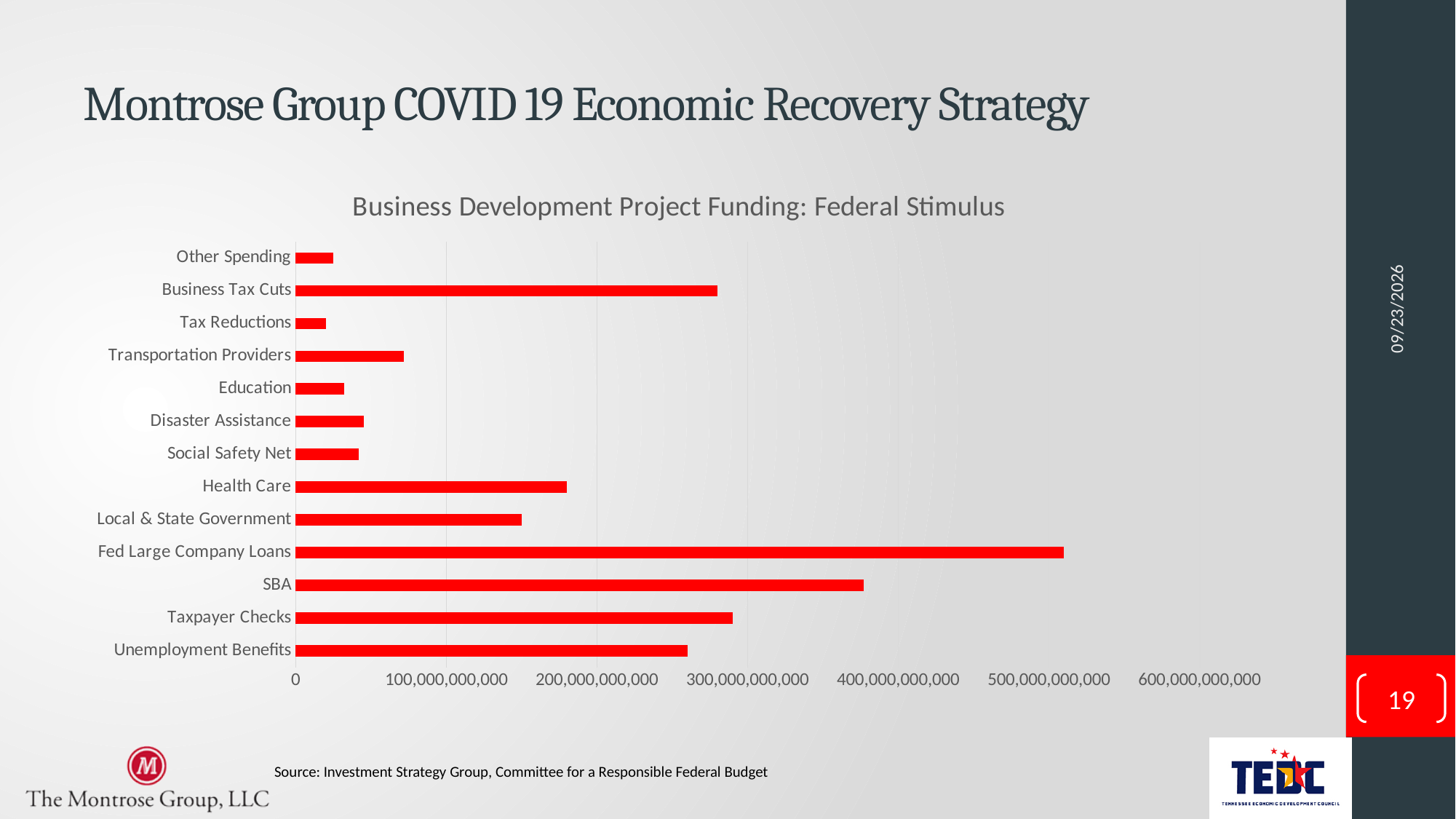
Is the value for SBA greater or less than 300,000,000,000? greater Which is larger, the value for Health Care or the value for Local & State Government? Health Care How many categories are plotted in the chart? 13 Which category has the highest value in the chart? Fed Large Company Loans Is the value for Transportation Providers greater or less than 100,000,000,000? less Is the value for Unemployment Benefits greater or less than 200,000,000,000? greater What is the title of the chart? Business Development Project Funding: Federal Stimulus What kind of chart is shown on the slide? Bar chart Which is larger, the value for SBA or the value for Taxpayer Checks? SBA What colour are the bars in the chart? Red